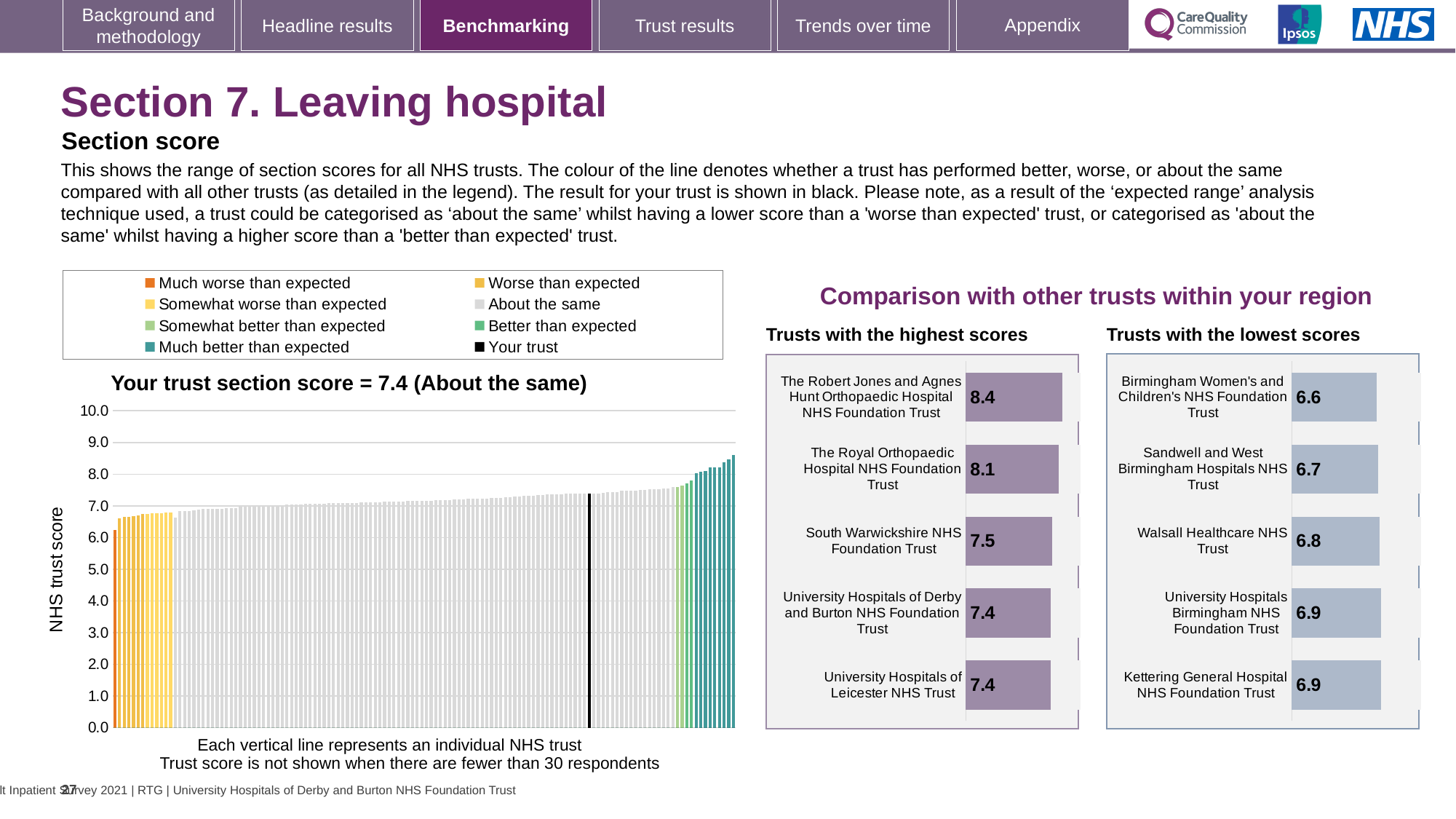
How many trusts are shown in the 'Trusts with the lowest scores' chart? 5 How many entries does the legend above the 'Your trust section score' chart list? 8 In the 'Trusts with the highest scores' chart, what is the score for South Warwickshire NHS Foundation Trust? 7.5 In the 'Trusts with the lowest scores' chart, which has the larger score: Sandwell and West Birmingham Hospitals NHS Trust or Walsall Healthcare NHS Trust? Walsall Healthcare NHS Trust In the 'Your trust section score' chart, what is the section score for your trust? 7.4 In the 'Trusts with the lowest scores' chart, which trust has the lowest score? Birmingham Women's and Children's NHS Foundation Trust In the 'Trusts with the highest scores' chart, what is the score for The Robert Jones and Agnes Hunt Orthopaedic Hospital NHS Foundation Trust? 8.4 In the 'Your trust section score' chart, is the value of the highest bar greater or less than 8.0? greater In the 'Trusts with the lowest scores' chart, what is the score for Birmingham Women's and Children's NHS Foundation Trust? 6.6 In the 'Trusts with the lowest scores' chart, what is the score for Walsall Healthcare NHS Trust? 6.8 In the 'Trusts with the highest scores' chart, what is the difference between the scores of The Robert Jones and Agnes Hunt Orthopaedic Hospital NHS Foundation Trust and South Warwickshire NHS Foundation Trust? 0.9 In the 'Trusts with the highest scores' chart, which trust has the highest score? The Robert Jones and Agnes Hunt Orthopaedic Hospital NHS Foundation Trust